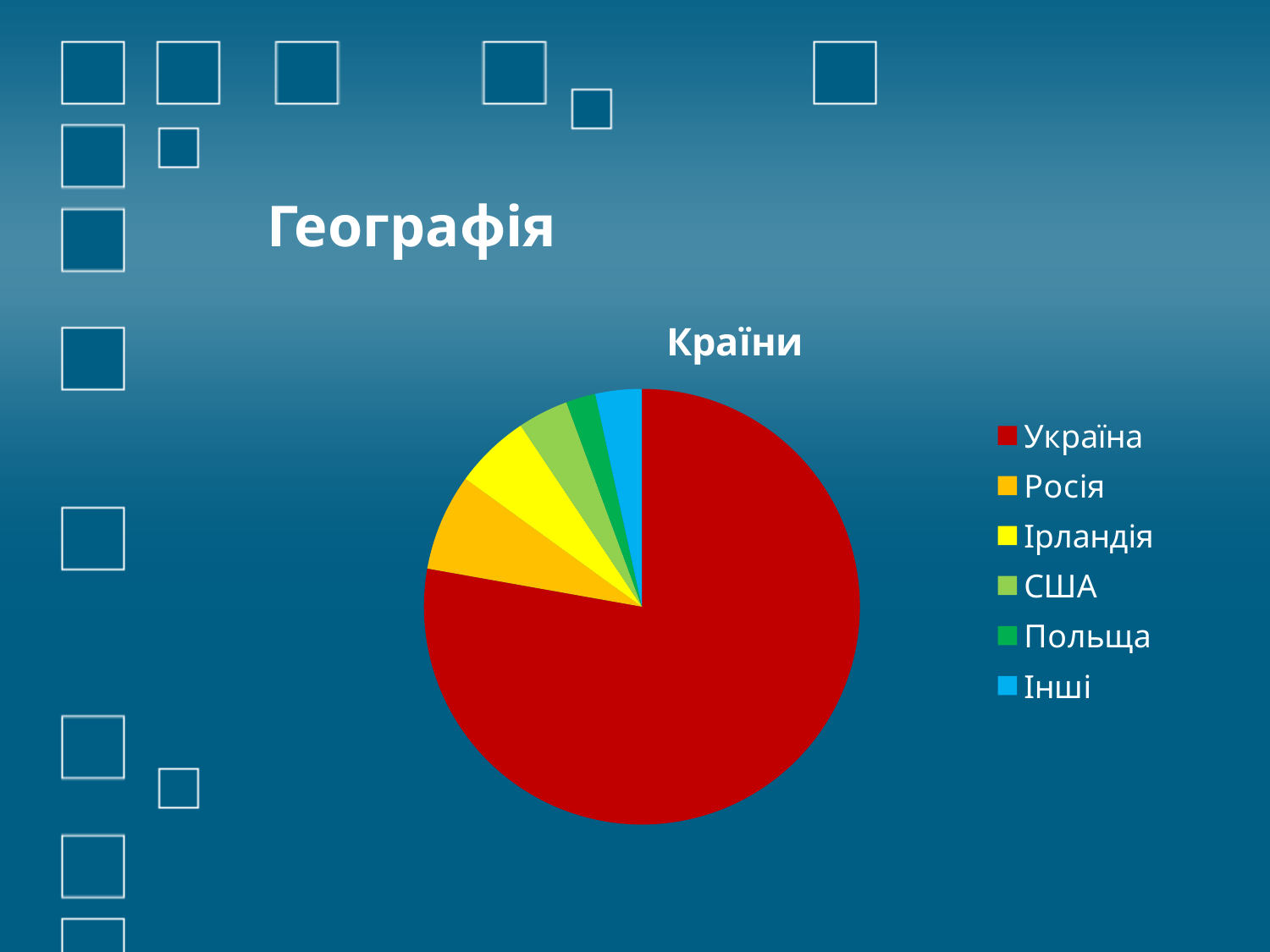
Which is larger, the slice for Ірландія or the slice for Польща? Ірландія Which is larger, the slice for Росія or the slice for Ірландія? Росія Which is larger, the slice for Україна or the slice for Росія? Україна What kind of chart is shown on the slide? pie chart Which category has the largest slice of the pie? Україна How many categories does the pie chart have? 6 What colour is the slice for Україна? red What is the title of the chart? Країни How many entries does the legend list? 6